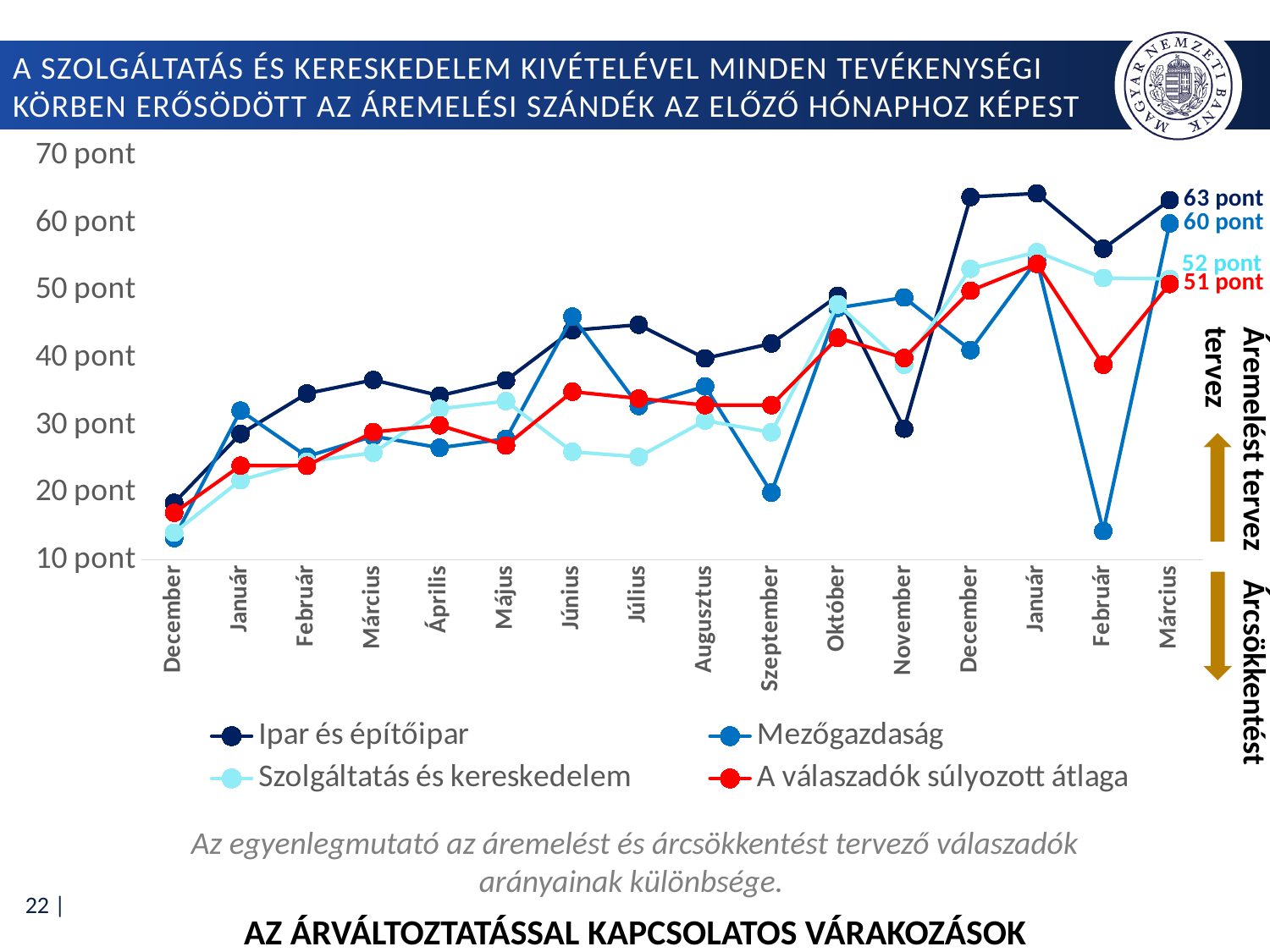
Which series has the highest value in the final Március? Ipar és építőipar What is the difference between Ipar és építőipar and Mezőgazdaság in the final Március? 3 pont How many months are shown along the x axis? 16 What is the value for Mezőgazdaság in the final Március? 60 pont Does the Ipar és építőipar series overall rise or fall from the first December to the final Március? rise Is the value for Mezőgazdaság in the second Február greater or less than 20 pont? less What is the value for Szolgáltatás és kereskedelem in the final Március? 52 pont What is the difference between Ipar és építőipar and A válaszadók súlyozott átlaga in the final Március? 12 pont How many series does the legend list? 4 What is the value for A válaszadók súlyozott átlaga in the final Március? 51 pont What type of chart is shown on the slide? line chart What is the value for Ipar és építőipar in the final Március? 63 pont